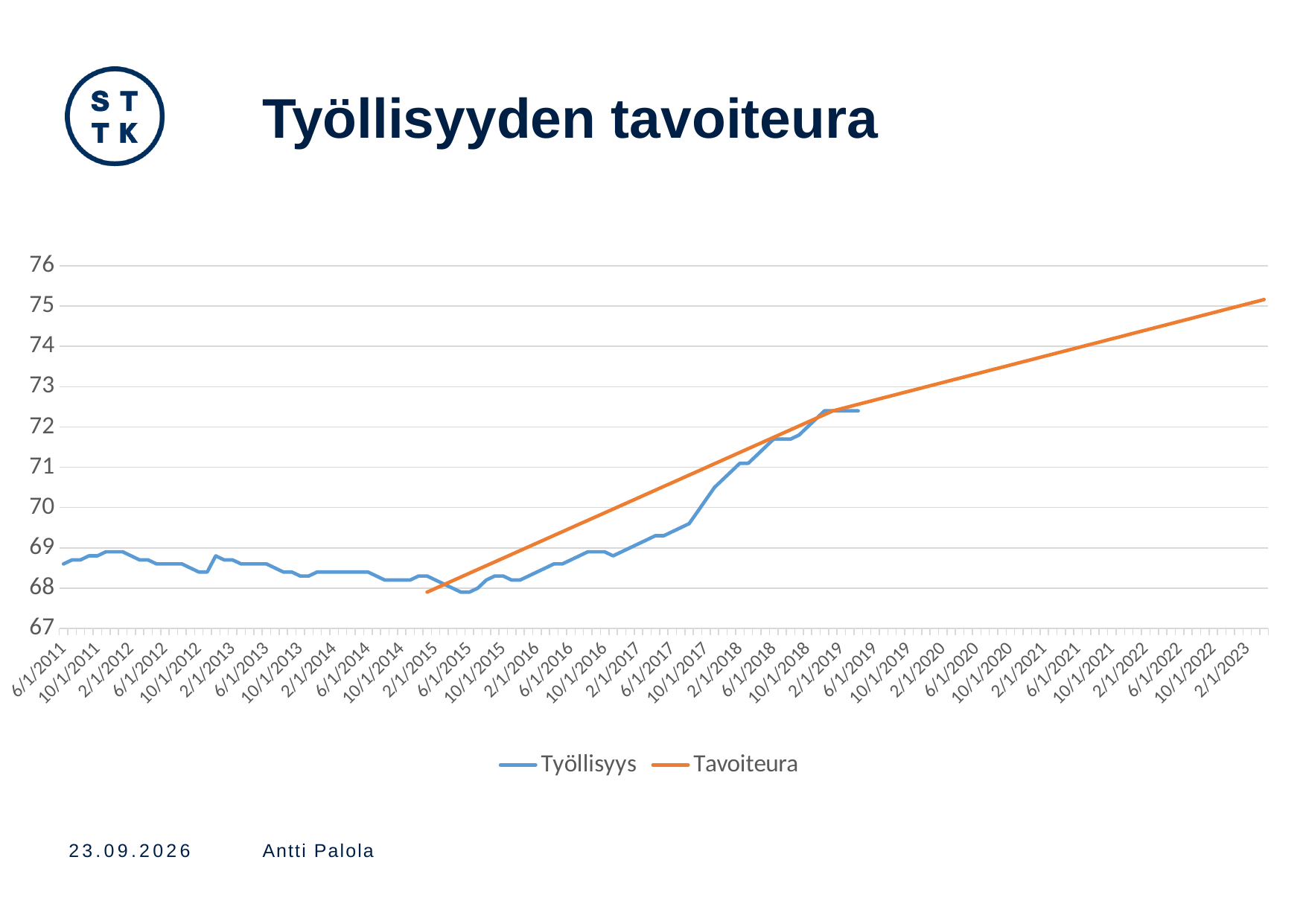
Which series is drawn in orange? Tavoiteura Is the value of Tavoiteura at 2/1/2023 greater or less than 74? greater Does the Tavoiteura line rise or fall from 2/1/2015 to 2/1/2023? rise Is the value of Työllisyys at 6/1/2011 greater or less than 68? greater At 10/1/2016, which series has the higher value, Työllisyys or Tavoiteura? Tavoiteura Is the value of Työllisyys at 2/1/2019 greater or less than 72? greater How many series does the legend list? 2 What is the title of the chart? Työllisyyden tavoiteura What kind of chart is shown on the slide? Line chart